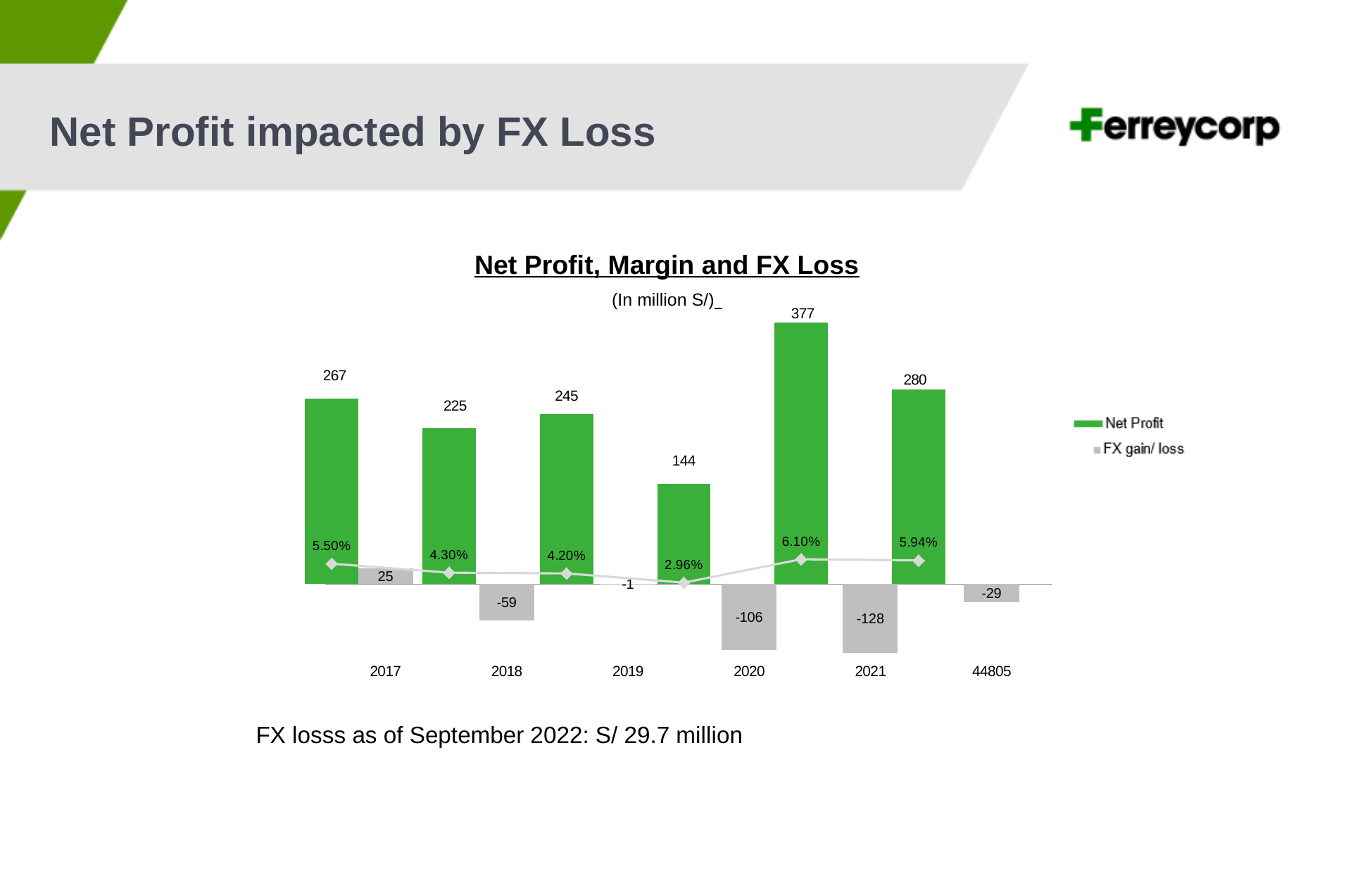
What margin percentage is shown for 2019? 4.20% Which year has the lowest Net Profit? 2020 What type of chart is used to show Net Profit? Bar chart Which year has the lowest margin percentage? 2020 What unit is stated below the chart title? In million S/ How many series does the legend list? 2 What is the FX gain/loss value for 2020? -106 Which is larger, the Net Profit for 2017 or the Net Profit for 2018? 2017 What is the difference between the Net Profit for 2021 and the Net Profit for 2020? 233 What is the FX gain/loss value for 2017? 25 Which year has the highest Net Profit? 2021 What is the Net Profit value for 2021? 377